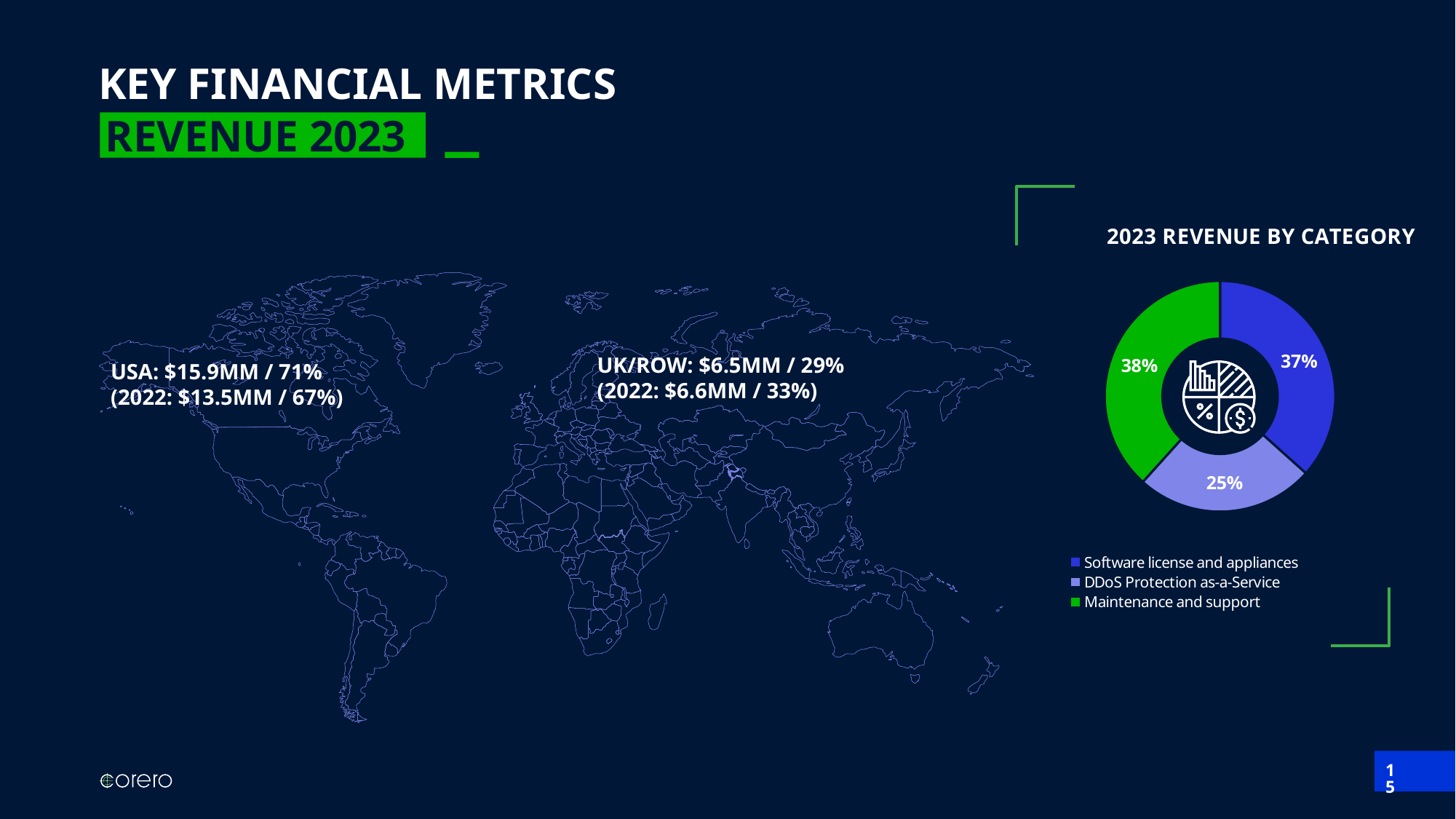
Which category has the smallest share in the 2023 Revenue by Category chart? DDoS Protection as-a-Service What is the title of the chart on the right side of the slide? 2023 REVENUE BY CATEGORY How many categories are shown in the 2023 Revenue by Category chart? 3 In the 2023 Revenue by Category chart, how many percentage points larger is the Software license and appliances share than the DDoS Protection as-a-Service share? 12 In the 2023 Revenue by Category chart, which is larger: the share for Software license and appliances or the share for DDoS Protection as-a-Service? Software license and appliances What share of 2023 revenue does DDoS Protection as-a-Service account for in the 2023 Revenue by Category chart? 25% Which colour represents Maintenance and support in the 2023 Revenue by Category chart? Green Which category has the largest share in the 2023 Revenue by Category chart? Maintenance and support In the 2023 Revenue by Category chart, what is the combined share of Software license and appliances and Maintenance and support? 75% What share of 2023 revenue does Maintenance and support account for in the 2023 Revenue by Category chart? 38% What share of 2023 revenue does Software license and appliances account for in the 2023 Revenue by Category chart? 37% What type of chart is the 2023 Revenue by Category chart? Pie (donut) chart